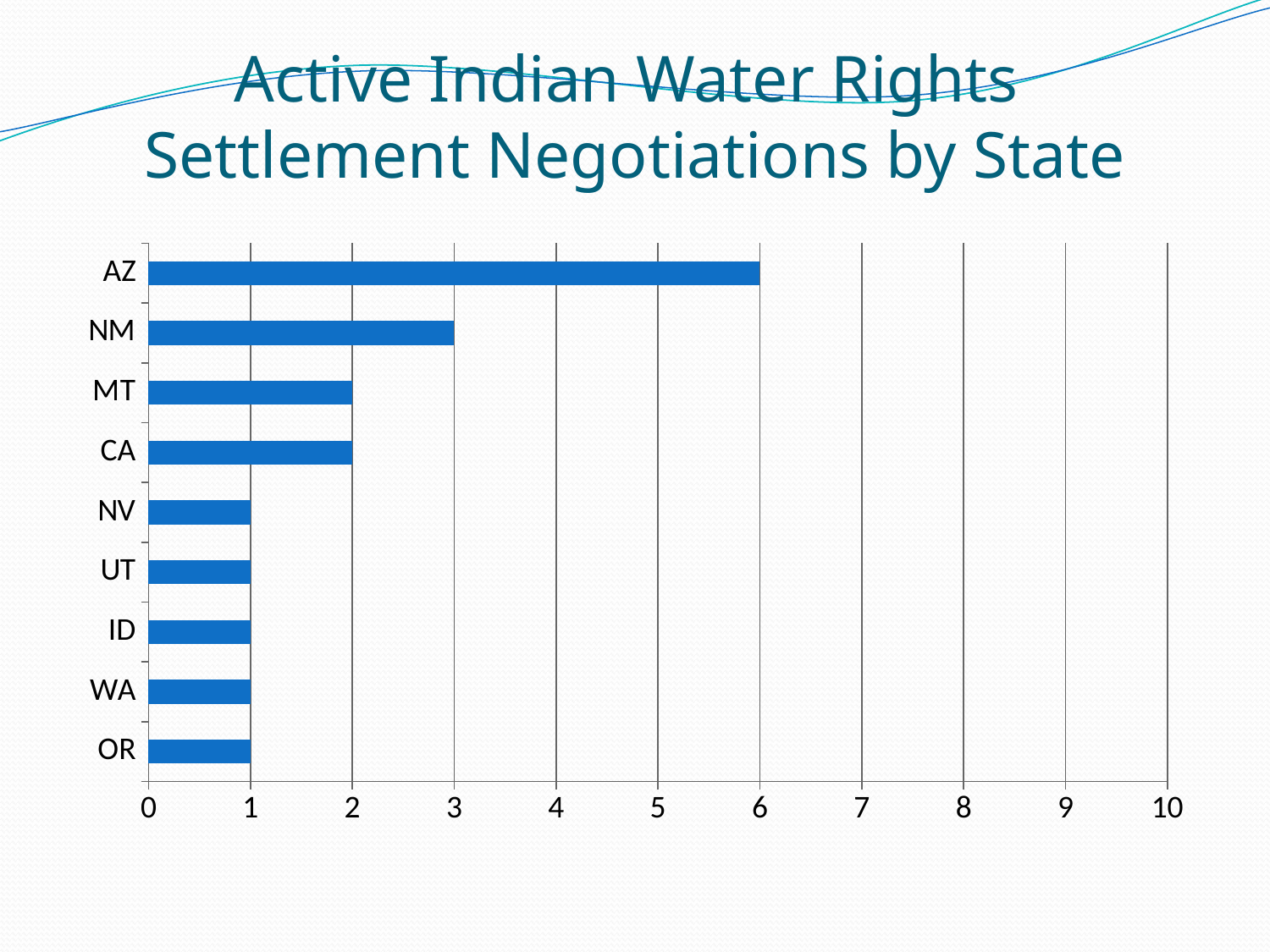
What is the difference between the values for CA and NV? 1 What is the value for OR? 1 What kind of chart is shown on the slide? Bar chart What is the difference between the values for AZ and NM? 3 Is the value for AZ greater or less than 5? greater Which state has the highest value? AZ What is the title of the slide? Active Indian Water Rights Settlement Negotiations by State What is the value for AZ? 6 What is the value for MT? 2 What is the value for NM? 3 Which is larger, the value for NM or the value for CA? NM How many states are shown on the chart? 9